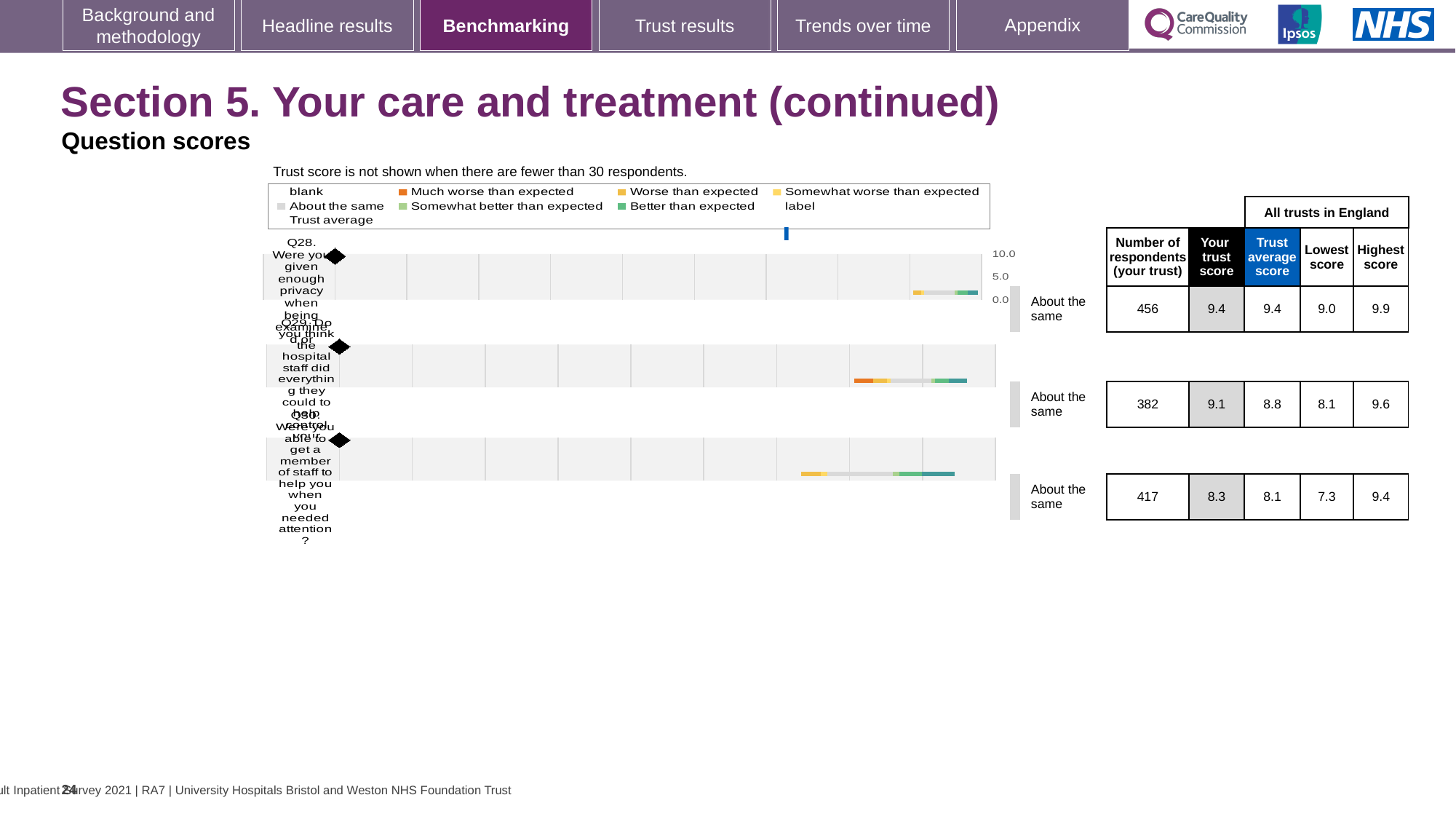
Is the trust score for Q29 larger or smaller than the trust score for Q30? larger How many respondents answered Q29 according to the table next to the chart? 382 How many questions (Q28, Q29, Q30) are plotted in the chart? 3 What is the trust average score for Q29 in the table next to the chart? 8.8 What benchmark category is shown for Q28 beside the chart? About the same What is the highest value shown on the chart's score axis? 10.0 What is the difference between the highest score and the lowest score for Q30 in the table? 2.1 Which question has the lowest trust score in the table next to the chart? Q30 What is the trust score for Q30 shown in the table next to the chart? 8.3 What is the trust score for Q28 shown in the table next to the chart? 9.4 What kind of chart is used to show the question scores on this slide? bar chart Which question has the highest trust score in the table next to the chart? Q28